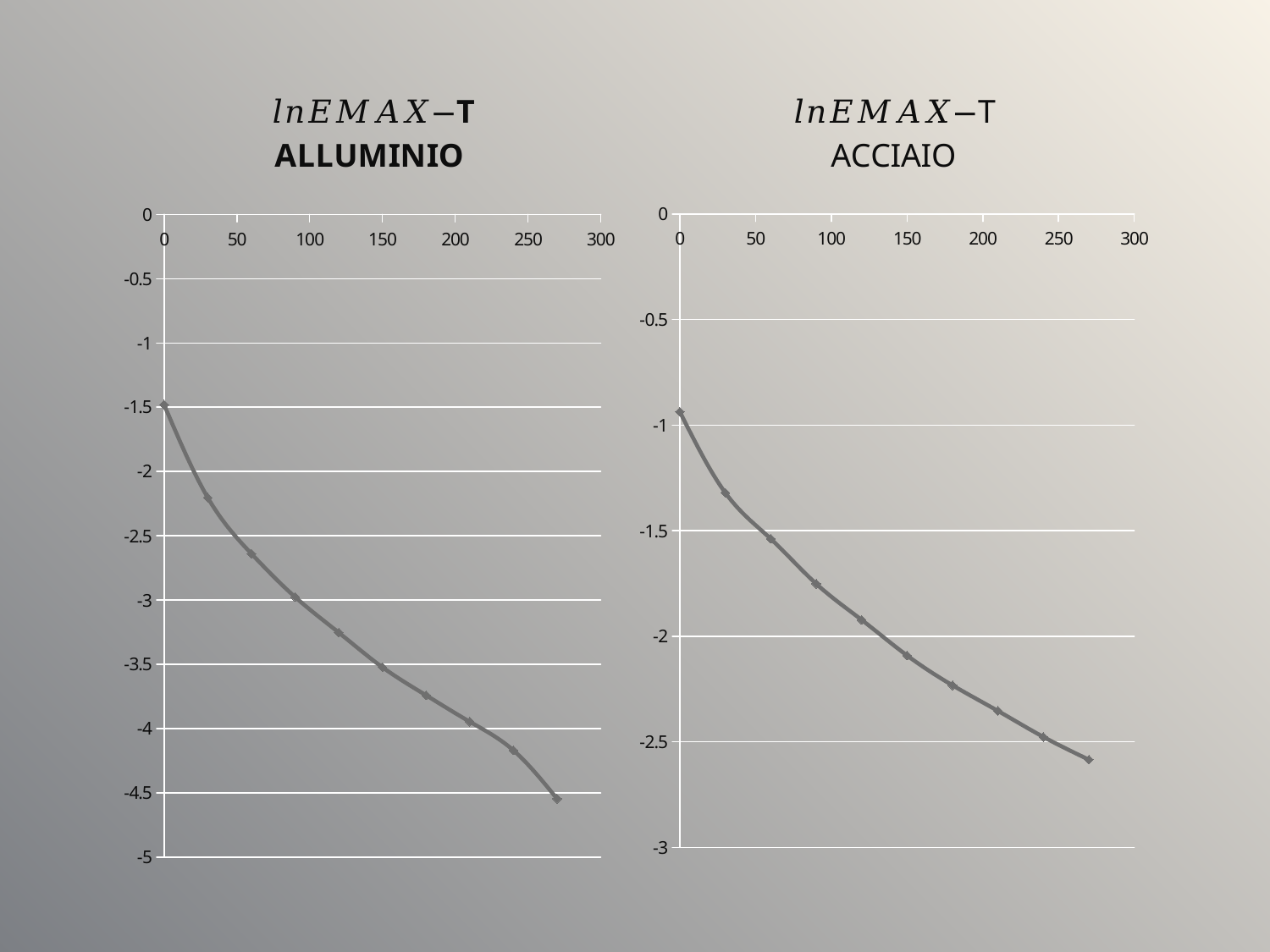
In the ALLUMINIO chart, at which T value is the plotted value highest? 0 How many data points are plotted in the ACCIAIO chart? 10 How many data points are plotted in the ALLUMINIO chart? 10 In the ACCIAIO chart, at which T value is the plotted value lowest? 270 In the ALLUMINIO chart, do the values rise or fall as T increases along the x axis? fall In the ACCIAIO chart, is the value at T = 0 greater or less than -1.5? greater What kind of chart is the ALLUMINIO chart on the left? line chart At T = 0, which chart shows the larger value, ALLUMINIO or ACCIAIO? ACCIAIO In the ACCIAIO chart, do the values rise or fall as T increases along the x axis? fall In the ALLUMINIO chart, is the value at T = 270 greater or less than -4? less In the ACCIAIO chart, is the value at T = 270 greater or less than -2? less